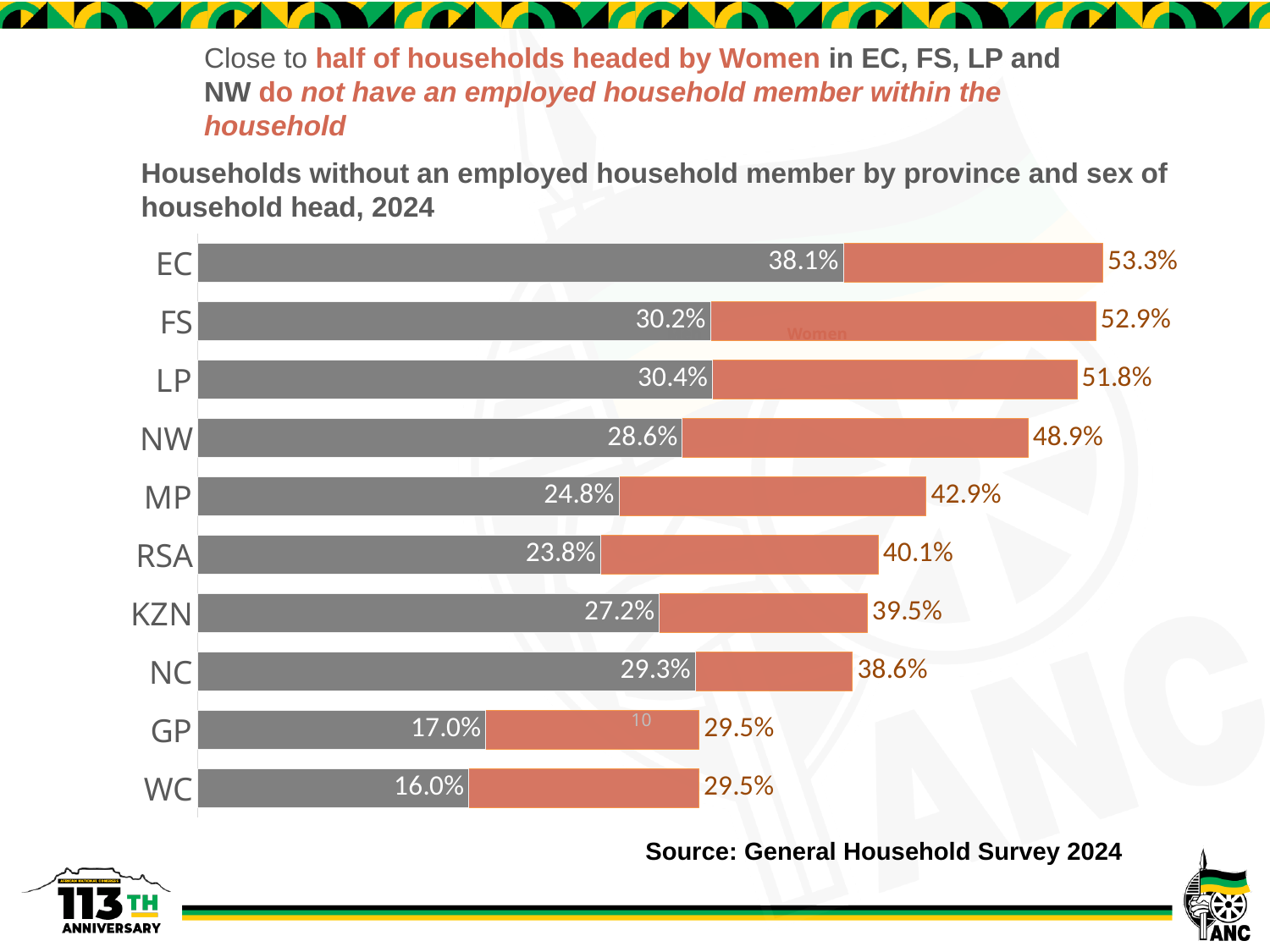
What is the difference between the grey values for GP and WC? 1.0 percentage point How many categories are shown on the chart? 10 What is the value of the orange bar for RSA? 40.1% Which has the larger orange value, MP or NC? MP What source is cited for the chart? General Household Survey 2024 What is the value of the orange bar for NW? 48.9% Which category has the lowest value for the grey bars? WC What type of chart is shown on the slide? Bar chart What is the value of the grey bar for KZN? 27.2% What is the title of the chart? Households without an employed household member by province and sex of household head, 2024 Which province has the highest value for the orange bars? EC What is the difference between the orange and grey values for EC? 15.2 percentage points